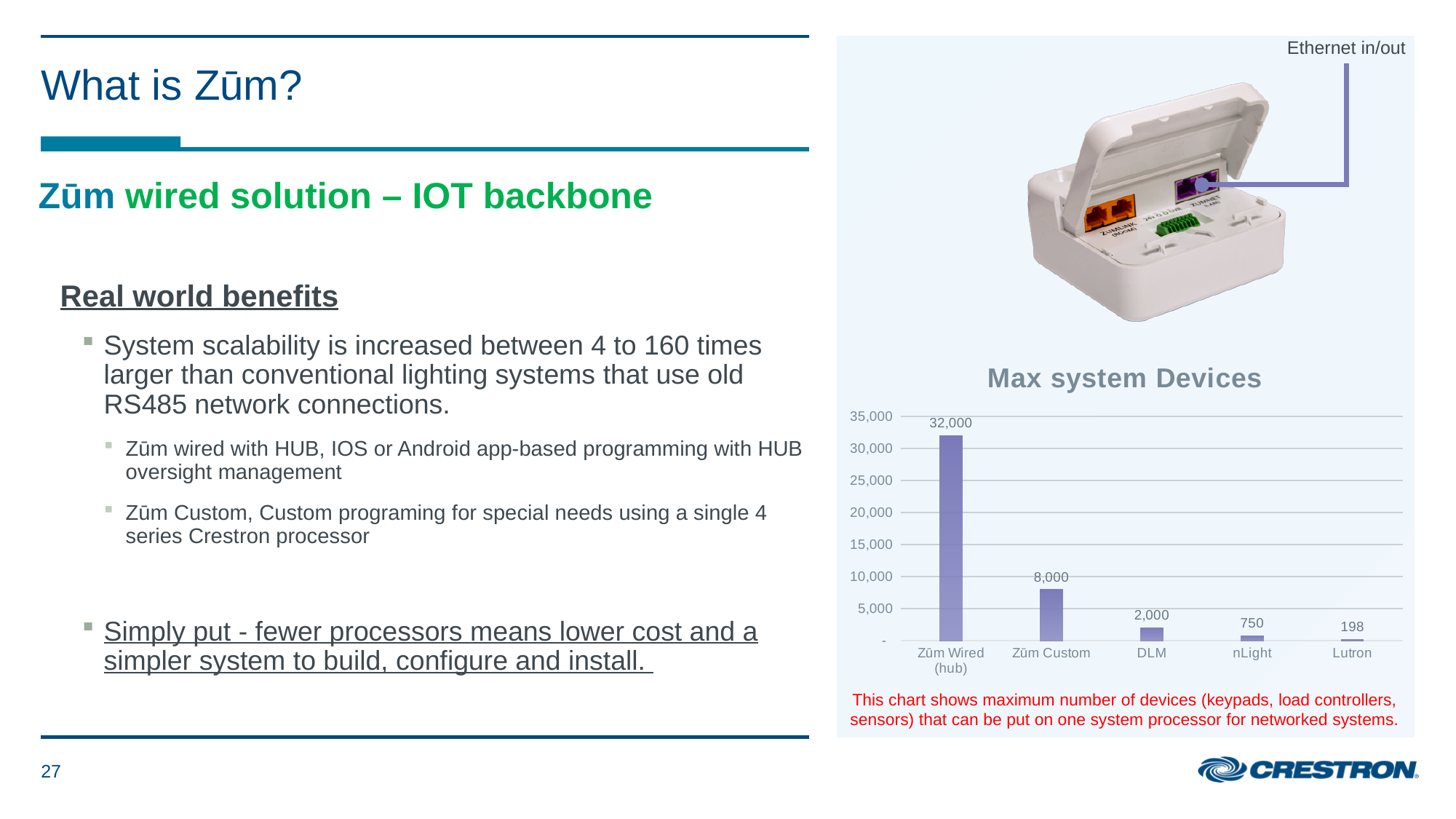
What is the value for Zūm Custom in the Max system Devices chart? 8,000 What is the value for Zūm Wired (hub) in the Max system Devices chart? 32,000 How many categories are shown in the Max system Devices chart? 5 Which category has the highest value in the Max system Devices chart? Zūm Wired (hub) What is the value for DLM in the Max system Devices chart? 2,000 What is the title of the chart on the slide? Max system Devices What is the difference between the values for Zūm Wired (hub) and Zūm Custom? 24,000 Which is larger in the Max system Devices chart, DLM or nLight? DLM What is the value for Lutron in the Max system Devices chart? 198 What type of chart is shown on the slide? bar chart What is the value for nLight in the Max system Devices chart? 750 Which category has the lowest value in the Max system Devices chart? Lutron